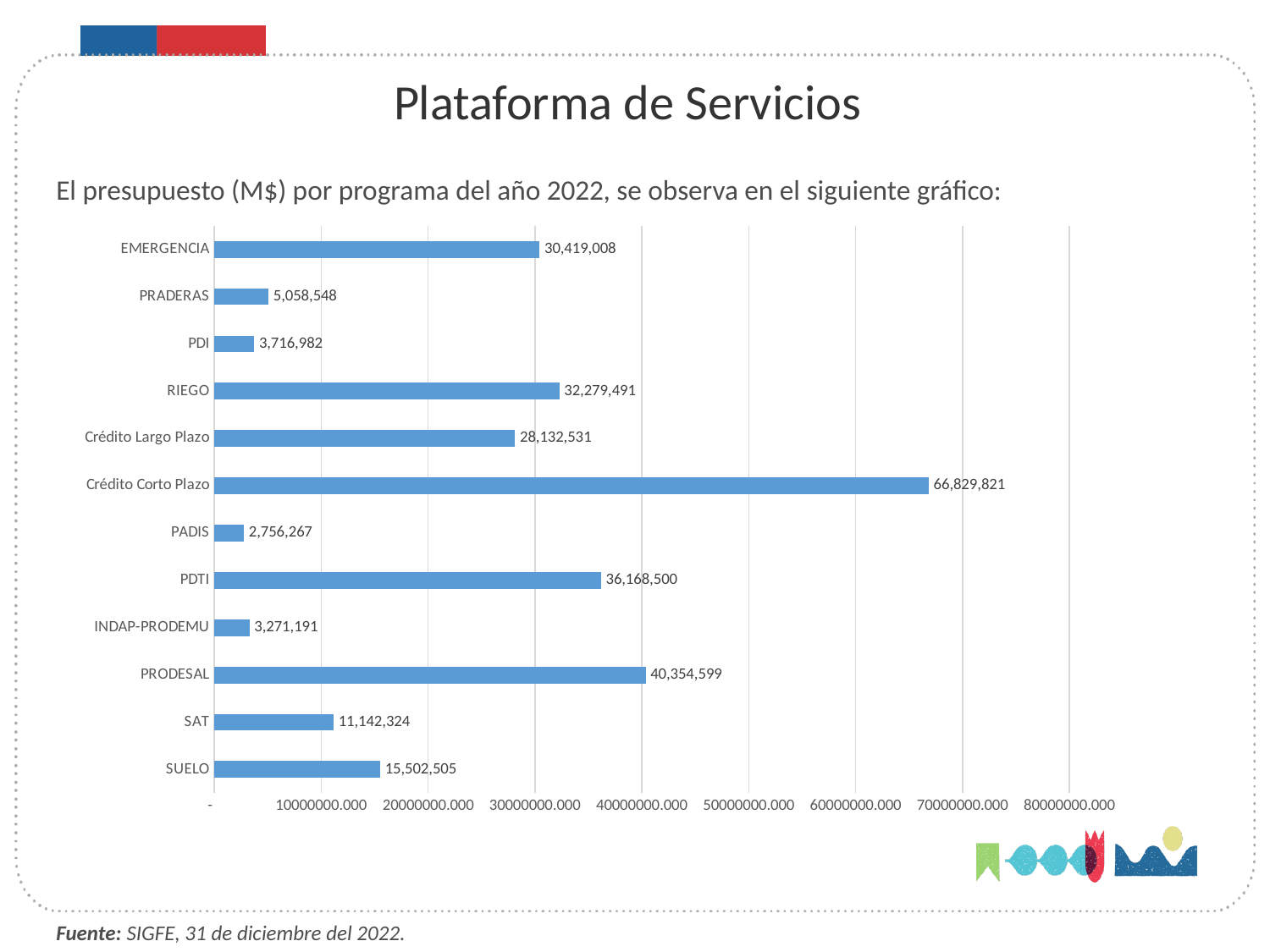
What is the value for Crédito Corto Plazo? 66,829,821 How many programs are shown in the chart? 12 Is the value for PDTI greater or less than 30000000? greater What is the value for INDAP-PRODEMU? 3,271,191 Which is larger, the value for RIEGO or the value for EMERGENCIA? RIEGO What is the difference between the values for Crédito Corto Plazo and PRODESAL? 26,475,222 What is the value for PRODESAL? 40,354,599 What is the difference between the values for SUELO and SAT? 4,360,181 What is the value for SAT? 11,142,324 Which program has the highest value? Crédito Corto Plazo What kind of chart is shown on the slide? bar chart Which program has the lowest value? PADIS